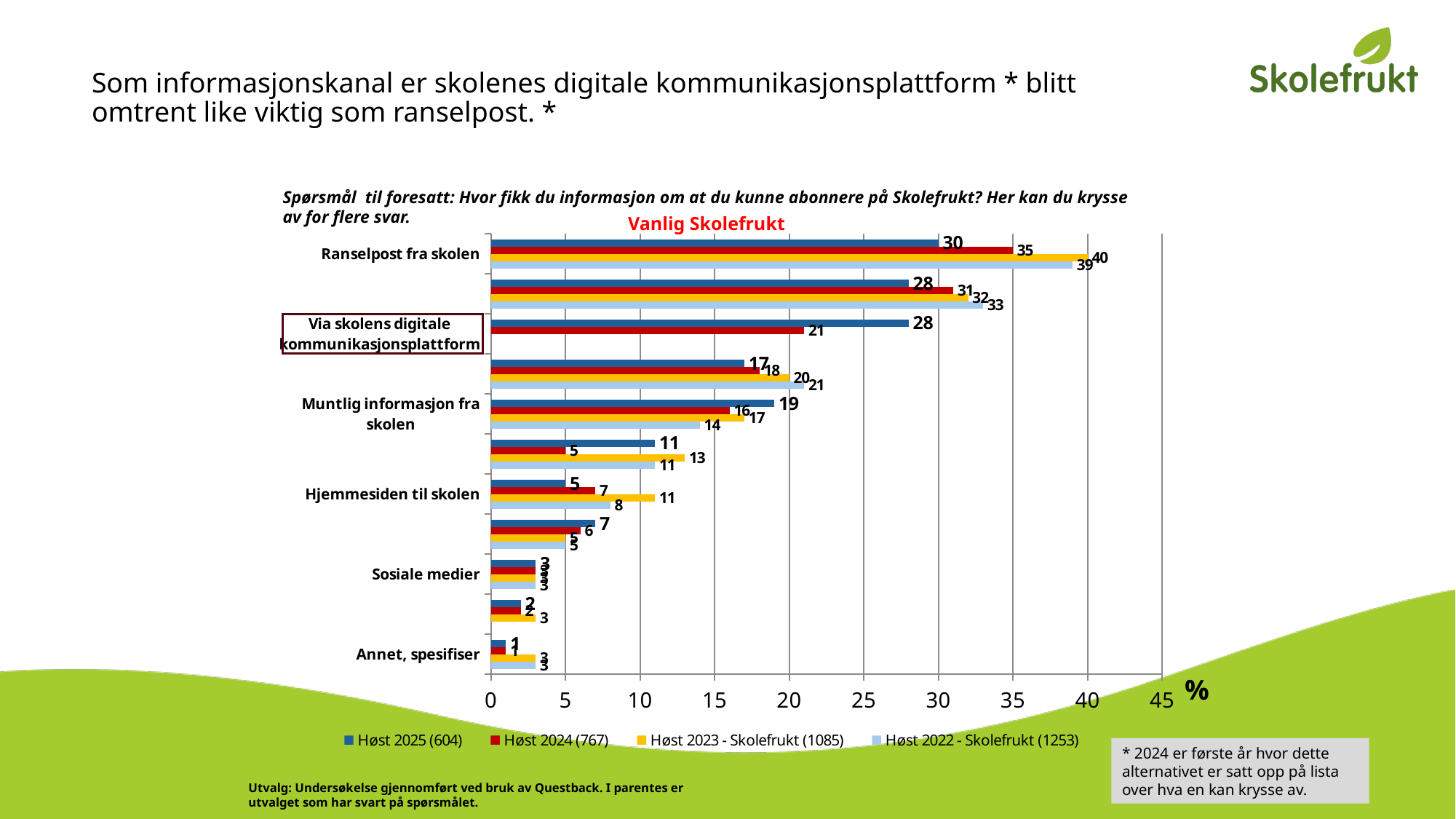
Which series has the highest value for Ranselpost fra skolen? Høst 2023 - Skolefrukt (1085) What is the Høst 2025 (604) value for Ranselpost fra skolen? 30 What is the Høst 2025 (604) value for Via skolens digitale kommunikasjonsplattform? 28 What is the Høst 2025 (604) value for Muntlig informasjon fra skolen? 19 How many series does the legend list? 4 What is the Høst 2023 - Skolefrukt (1085) value for Ranselpost fra skolen? 40 What is the Høst 2024 (767) value for Via skolens digitale kommunikasjonsplattform? 21 What is the Høst 2022 - Skolefrukt (1253) value for Muntlig informasjon fra skolen? 14 What type of chart is shown on the slide? Bar chart For Ranselpost fra skolen, which is larger: the Høst 2024 (767) value or the Høst 2025 (604) value? Høst 2024 (767) What is the Høst 2023 - Skolefrukt (1085) value for Hjemmesiden til skolen? 11 What is the difference between the Høst 2023 - Skolefrukt (1085) and Høst 2025 (604) values for Ranselpost fra skolen? 10